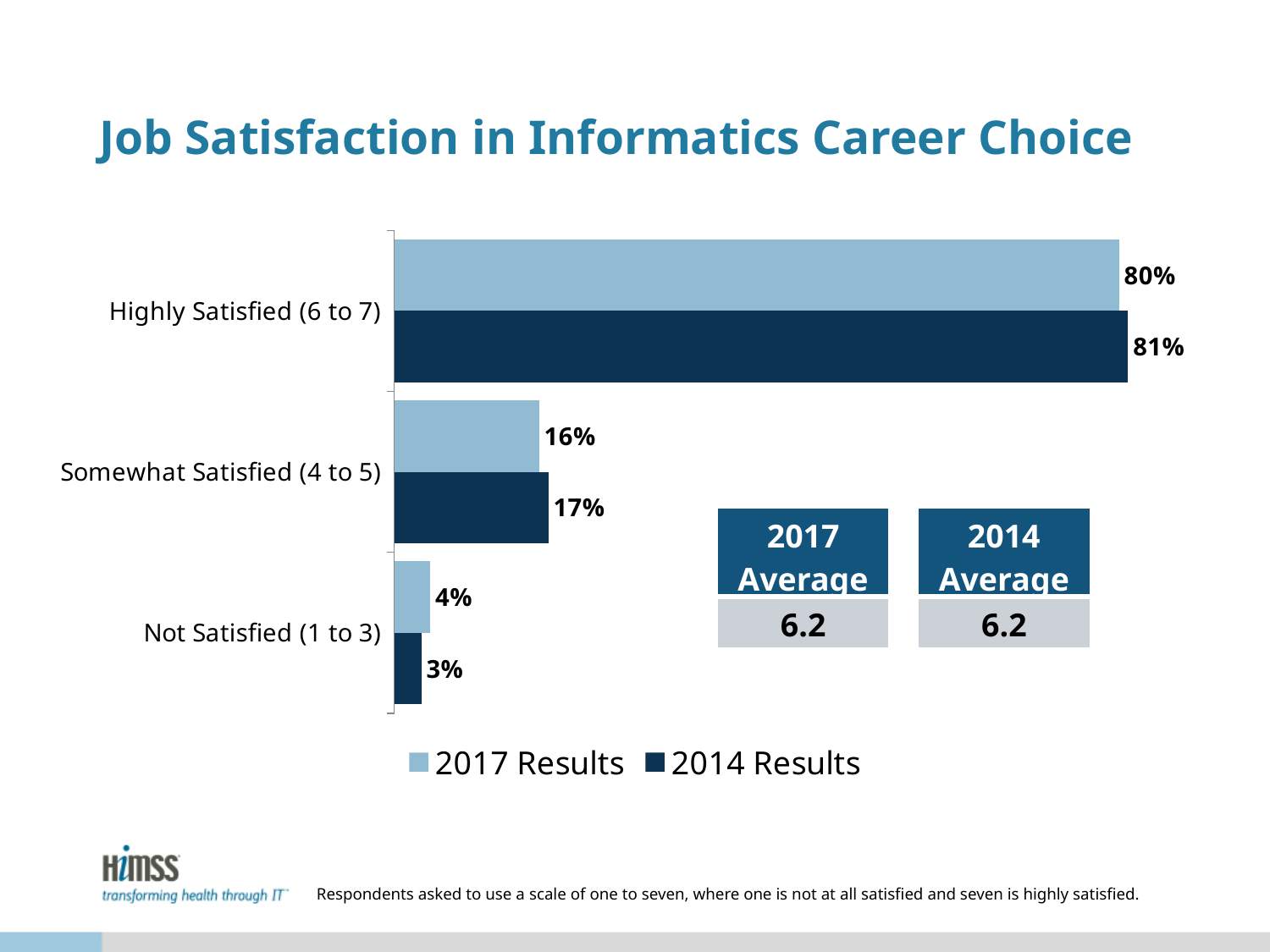
What is the 2014 Results value for Not Satisfied (1 to 3)? 3% Which category has the highest 2017 Results value? Highly Satisfied (6 to 7) Which category has the lowest 2014 Results value? Not Satisfied (1 to 3) What is the difference between the 2014 Results and 2017 Results values for Somewhat Satisfied (4 to 5)? 1% What is the 2017 Results value for Somewhat Satisfied (4 to 5)? 16% How many series does the legend list? 2 How many categories are shown on the chart? 3 What kind of chart is shown on the slide? Bar chart Which is larger for Not Satisfied (1 to 3): the 2017 Results value or the 2014 Results value? 2017 Results What is the 2014 Results value for Highly Satisfied (6 to 7)? 81% What is the 2017 Average shown on the slide? 6.2 What is the 2017 Results value for Highly Satisfied (6 to 7)? 80%